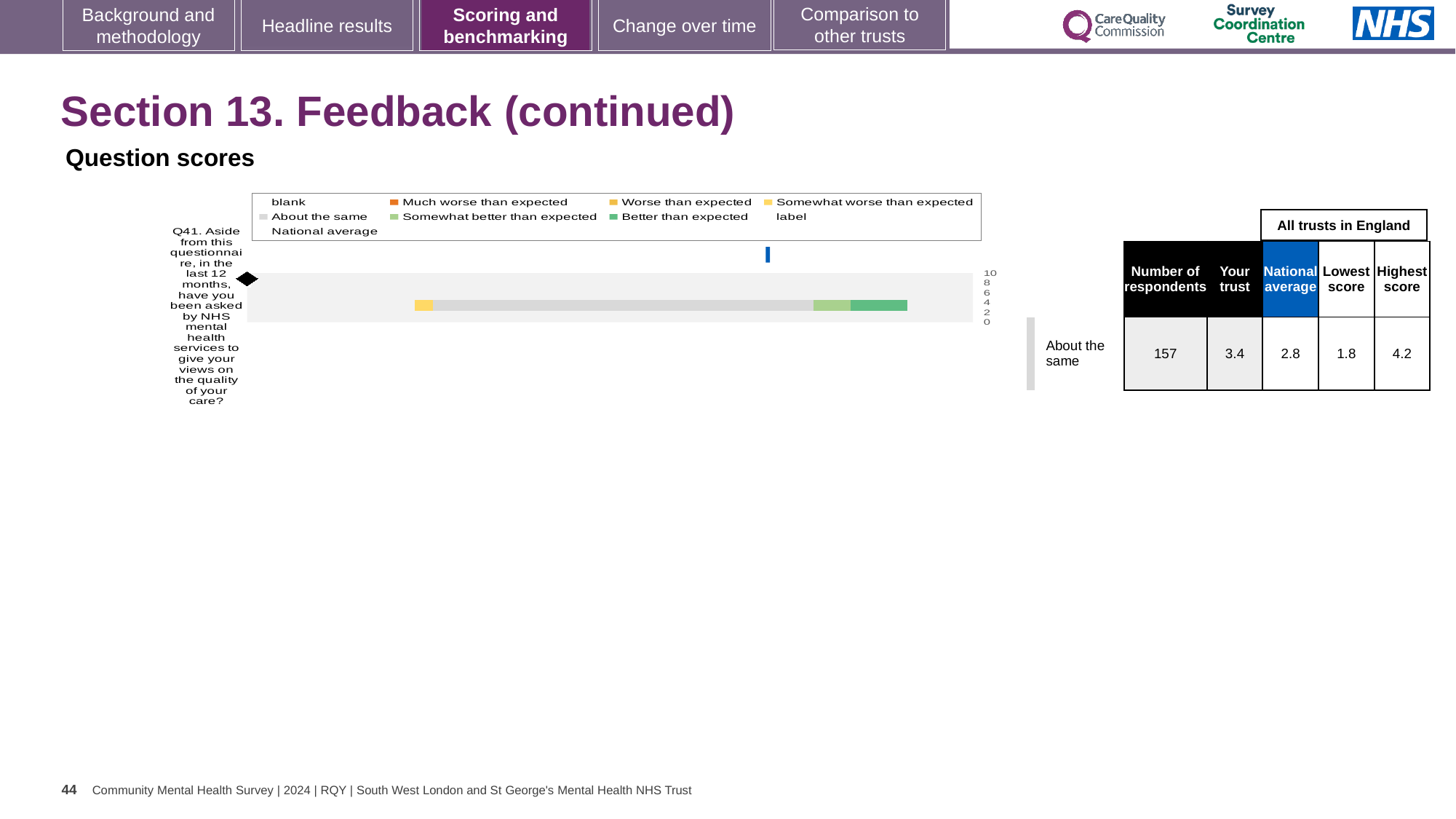
Which is larger for Q41, the 'Your trust' score or the national average? Your trust What benchmark category is Q41 assigned to, as shown beside the chart? About the same Which question number is plotted in the chart? Q41 In the table next to the chart, what is the lowest score among all trusts in England for Q41? 1.8 How many questions (categories) are plotted in the chart? 1 What is the difference between the highest score and the lowest score for Q41 in the table? 2.4 In the table next to the chart, what is the highest score among all trusts in England for Q41? 4.2 In the table next to the chart, what is the number of respondents for Q41? 157 What kind of chart is shown on the slide? bar chart In the table next to the chart, what is the 'Your trust' score for Q41? 3.4 In the table next to the chart, what is the national average score for Q41? 2.8 What colour is the 'About the same' segment in the chart legend? grey